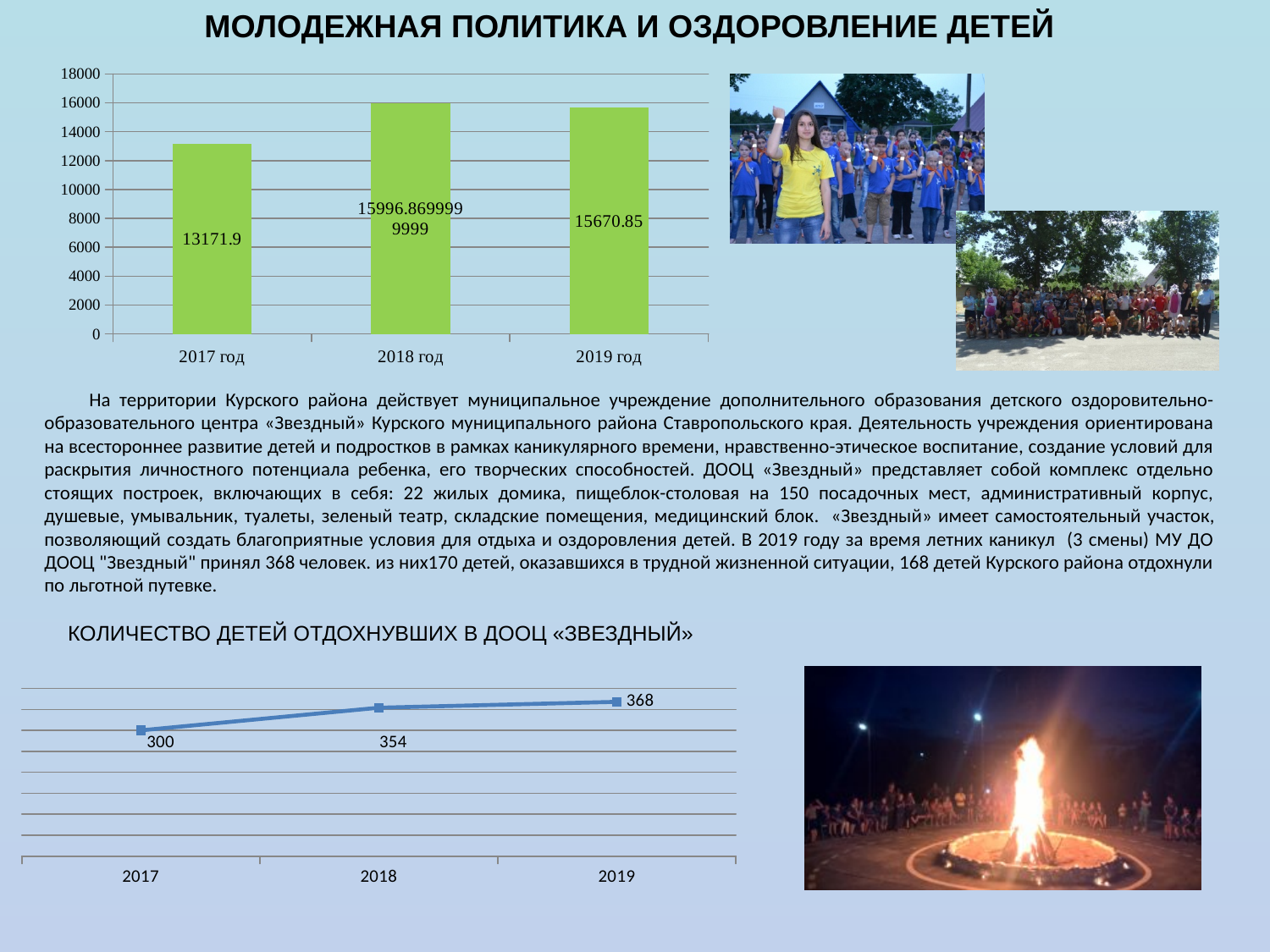
In the top bar chart, what is the difference between the values for 2019 год and 2017 год? 2498.95 In the chart titled 'КОЛИЧЕСТВО ДЕТЕЙ ОТДОХНУВШИХ В ДООЦ «ЗВЕЗДНЫЙ»', do the values rise or fall from 2017 to 2019? rise In the top bar chart, what is the value for 2019 год? 15670.85 In the top bar chart, which year has the highest value? 2018 год What kind of chart is the bottom chart on the slide? line chart In the chart titled 'КОЛИЧЕСТВО ДЕТЕЙ ОТДОХНУВШИХ В ДООЦ «ЗВЕЗДНЫЙ»', what is the difference between the values for 2019 and 2017? 68 What kind of chart is the top chart on the slide? bar chart How many categories does the top bar chart show? 3 In the top bar chart, which year has the lowest value? 2017 год In the top bar chart, is the value for 2017 год greater or less than 14000? less In the top bar chart, what is the value for 2017 год? 13171.9 In the chart titled 'КОЛИЧЕСТВО ДЕТЕЙ ОТДОХНУВШИХ В ДООЦ «ЗВЕЗДНЫЙ»', what is the value for 2018? 354